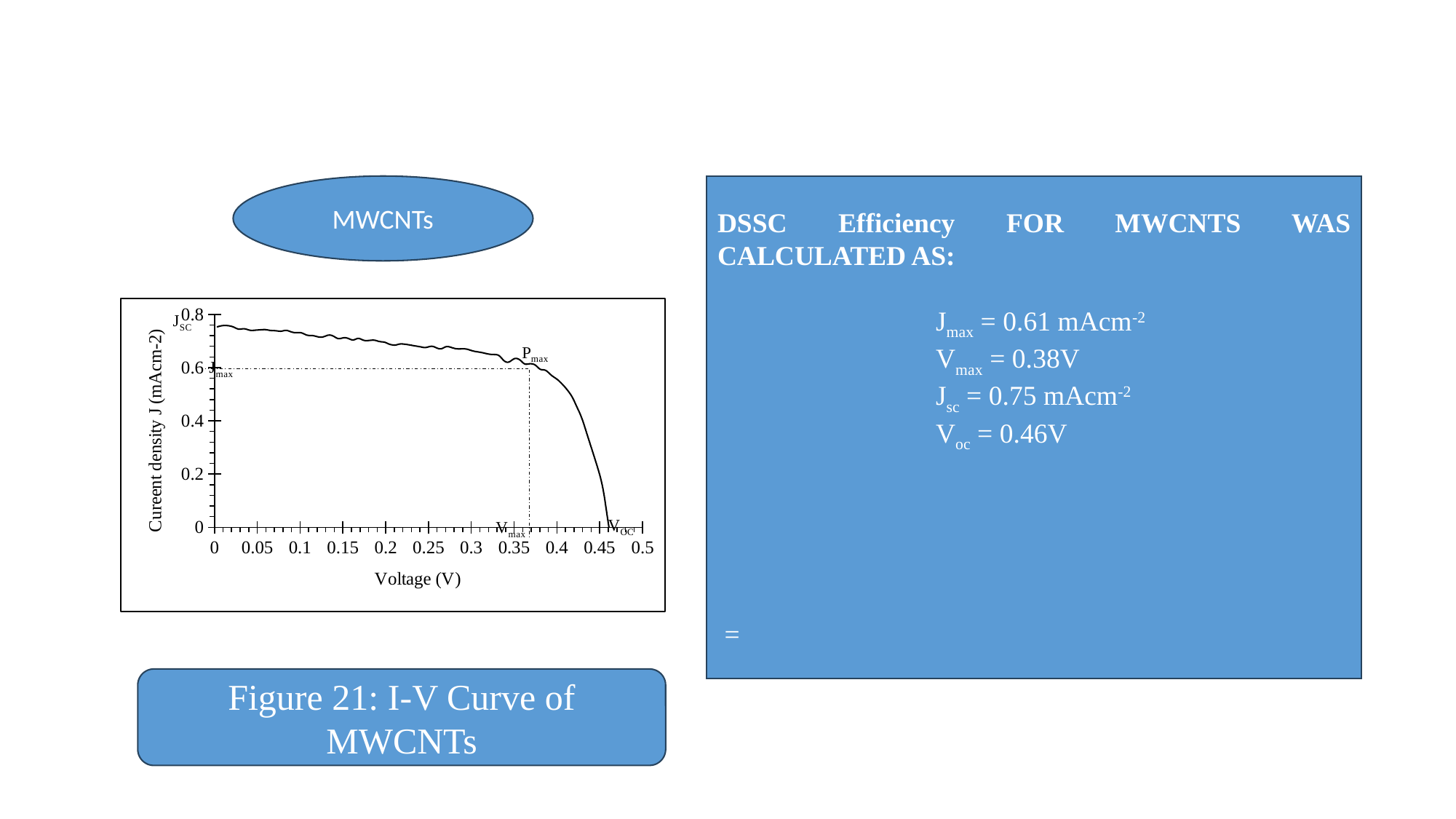
Is the current density at 0.2 V on the I-V curve greater or less than 0.6? greater What is the title of the x axis of the I-V curve chart? Voltage (V) According to the slide, what is the value of Jsc for MWCNTs? 0.75 mAcm-2 What kind of chart is shown in Figure 21? line chart According to the slide, what is the value of Voc for MWCNTs? 0.46V How many tick labels are shown on the x axis of the I-V curve chart? 11 Is the current density at 0.4 V on the I-V curve greater or less than 0.4? greater What is the title of the y axis of the I-V curve chart? Cureent density J (mAcm-2) Is the current density at 0 V on the I-V curve greater or less than 0.6? greater What is the highest value labelled on the y axis of the I-V curve chart? 0.8 Does the current density rise or fall as voltage increases along the x axis of the I-V curve? fall